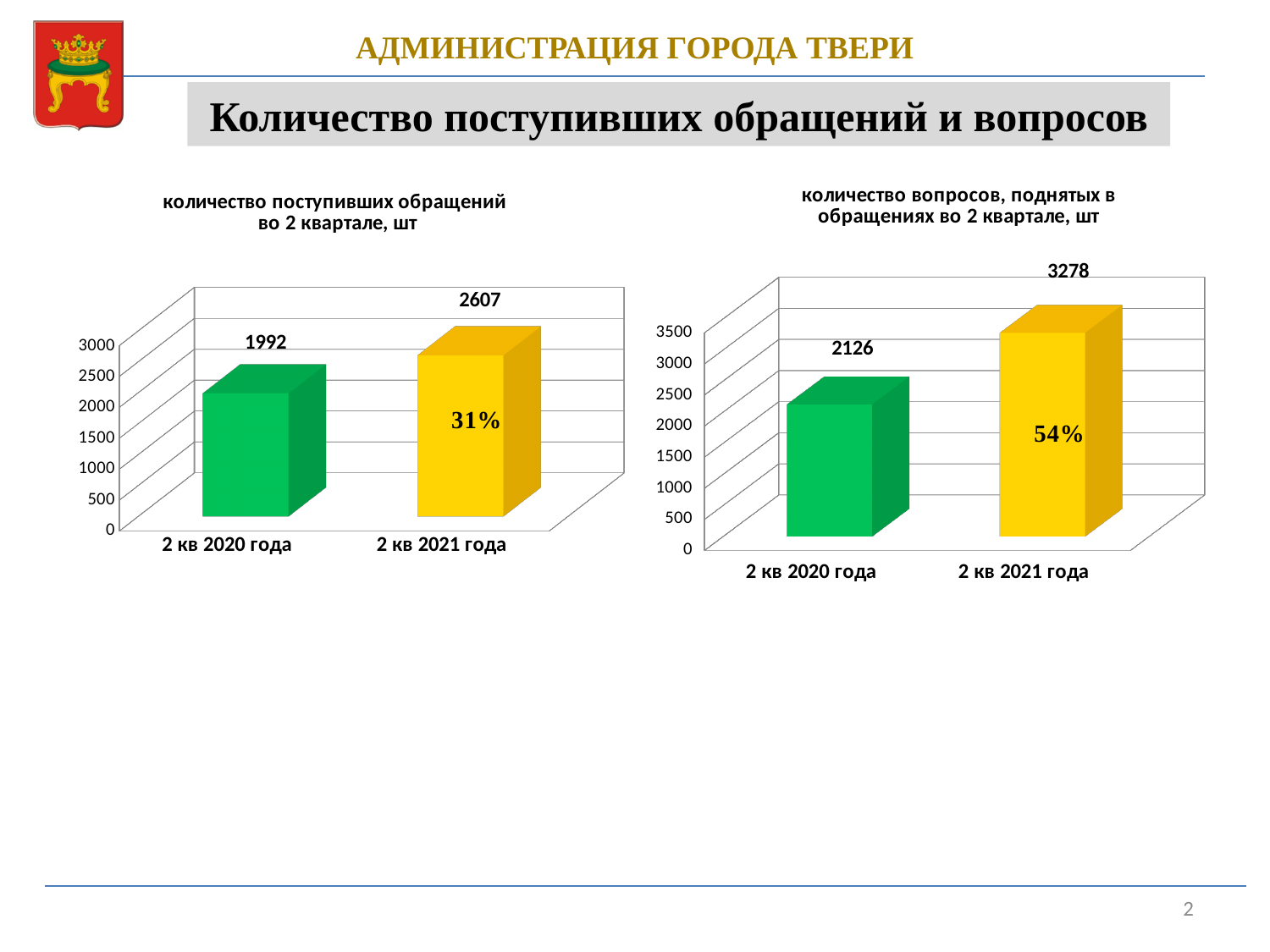
In the left chart (количество поступивших обращений во 2 квартале, шт), what is the value for 2 кв 2021 года? 2607 In the left chart, what is the difference between the values for 2 кв 2021 года and 2 кв 2020 года? 615 How many categories are shown in the left chart? 2 In the right chart, is the value for 2 кв 2021 года greater or less than 3000? greater In the left chart, which category has the higher value? 2 кв 2021 года In the left chart (количество поступивших обращений во 2 квартале, шт), what is the value for 2 кв 2020 года? 1992 In the right chart, which category has the lower value? 2 кв 2020 года In the right chart (количество вопросов, поднятых в обращениях во 2 квартале, шт), what is the value for 2 кв 2020 года? 2126 What kind of chart is the right chart? bar chart In the right chart (количество вопросов, поднятых в обращениях во 2 квартале, шт), what is the value for 2 кв 2021 года? 3278 In the right chart, what is the difference between the values for 2 кв 2021 года and 2 кв 2020 года? 1152 What percentage label is printed on the 2 кв 2021 года bar in the right chart? 54%